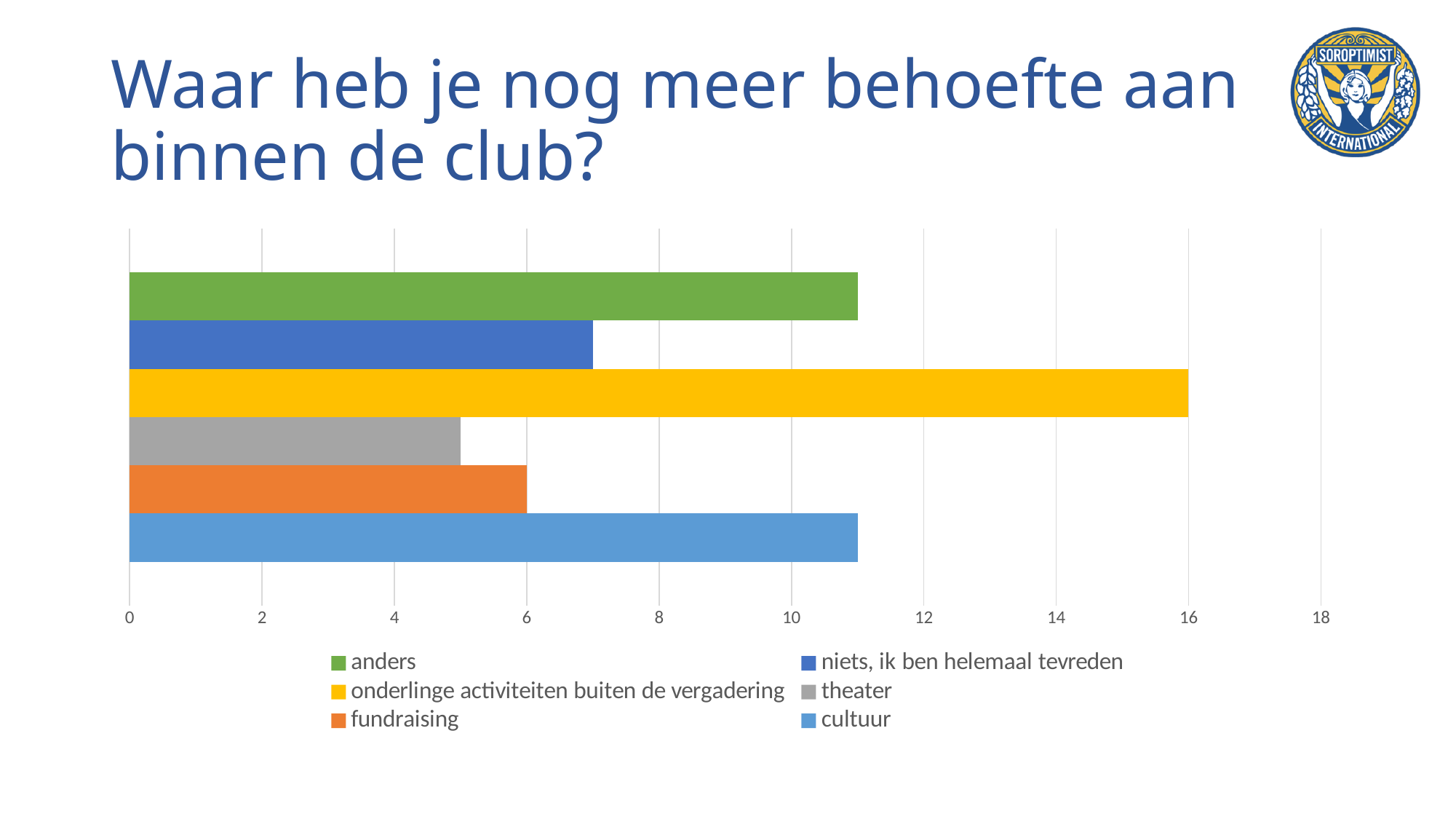
Which is larger, the value for 'cultuur' or the value for 'theater'? cultuur What colour is the bar for 'theater'? grey What is the value for 'fundraising'? 6 Is the value for 'anders' greater or less than 10? greater Is the value for 'niets, ik ben helemaal tevreden' greater or less than 8? less What is the value for 'onderlinge activiteiten buiten de vergadering'? 16 What is the difference between the values for 'onderlinge activiteiten buiten de vergadering' and 'fundraising'? 10 Which series has the lowest value? theater What kind of chart is shown on the slide? bar chart How many bars are plotted in the chart? 6 How many series does the legend list? 6 Which series has the highest value? onderlinge activiteiten buiten de vergadering